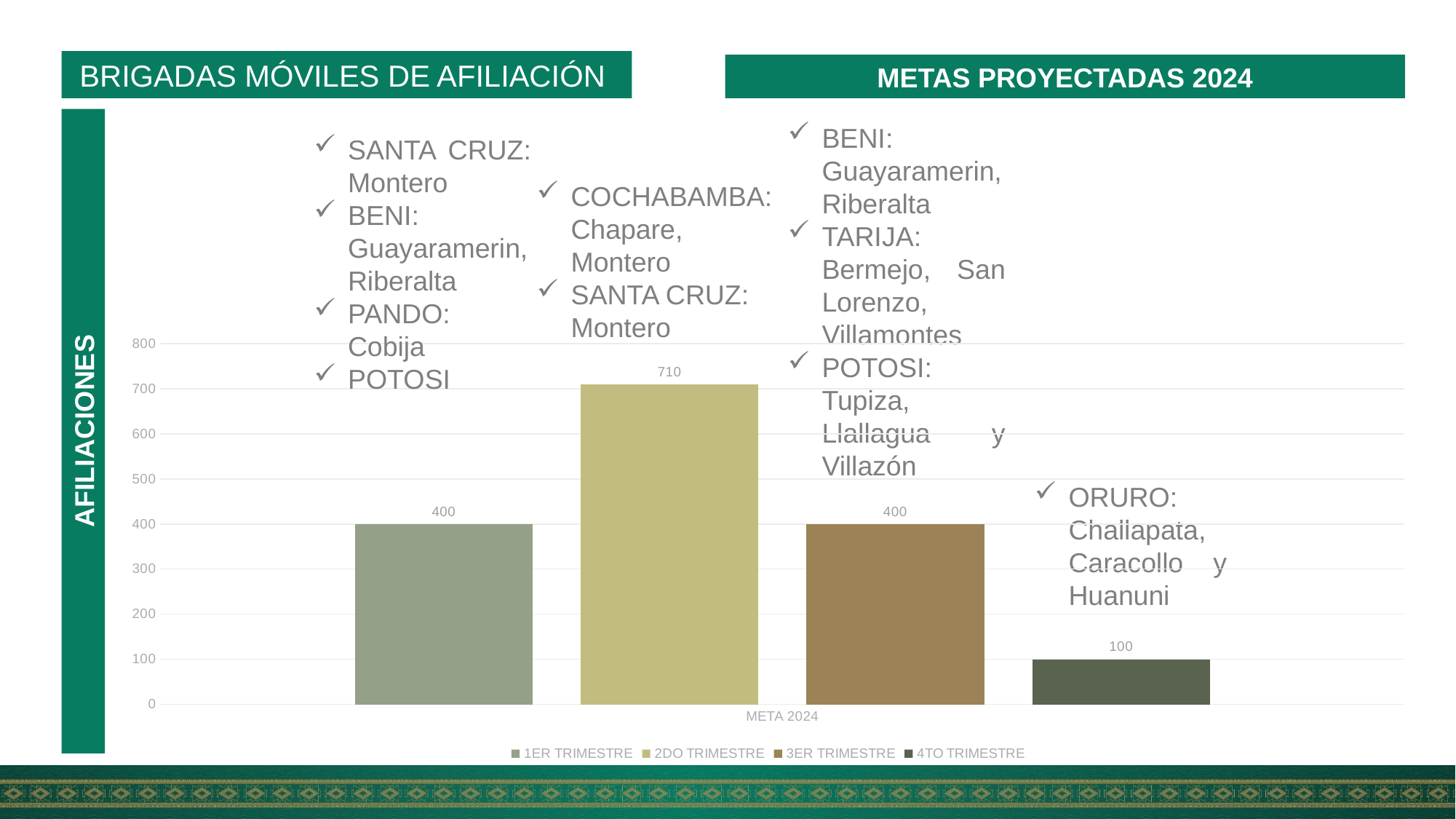
What kind of chart is shown on the slide? bar chart How many series does the legend list? 4 Which series has the highest value? 2DO TRIMESTRE What is the value for 4TO TRIMESTRE? 100 What is the difference between the values for 2DO TRIMESTRE and 3ER TRIMESTRE? 310 What is the value for 2DO TRIMESTRE? 710 Which is larger, the value for 2DO TRIMESTRE or the value for 1ER TRIMESTRE? 2DO TRIMESTRE What is the value for 1ER TRIMESTRE? 400 Which series has the lowest value? 4TO TRIMESTRE What is the difference between the values for 1ER TRIMESTRE and 4TO TRIMESTRE? 300 What is the label on the vertical axis of the chart? AFILIACIONES Is the value for 2DO TRIMESTRE greater or less than 600? greater